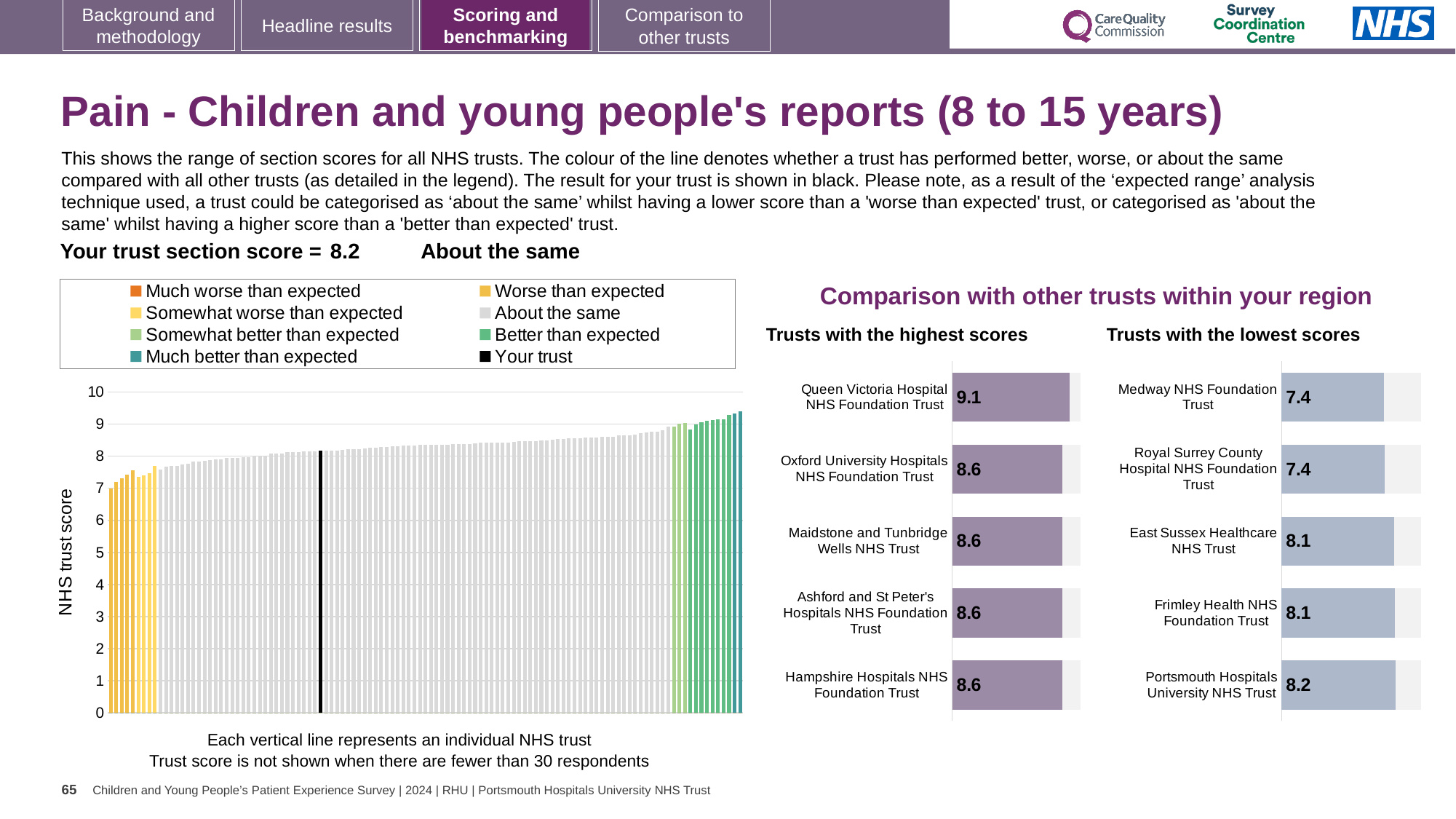
In the 'Trusts with the highest scores' chart, what is the score for Queen Victoria Hospital NHS Foundation Trust? 9.1 How many trusts are shown in the 'Trusts with the lowest scores' chart? 5 How many entries does the legend of the main NHS trust score chart list? 8 Which is larger: the score for East Sussex Healthcare NHS Trust or the score for Portsmouth Hospitals University NHS Trust in the lowest scores chart? Portsmouth Hospitals University NHS Trust What kind of chart is the main chart with the y-axis labelled 'NHS trust score'? Bar chart In the 'Trusts with the highest scores' chart, which trust has the highest score? Queen Victoria Hospital NHS Foundation Trust In the 'Trusts with the lowest scores' chart, what is the score for Medway NHS Foundation Trust? 7.4 In the 'Trusts with the highest scores' chart, what is the difference between Queen Victoria Hospital NHS Foundation Trust and Oxford University Hospitals NHS Foundation Trust? 0.5 In the main NHS trust score chart, do the bar heights rise or fall from left to right? Rise In the 'Trusts with the lowest scores' chart, what is the score for Portsmouth Hospitals University NHS Trust? 8.2 In the 'Trusts with the lowest scores' chart, which trust has the highest score shown? Portsmouth Hospitals University NHS Trust What is the difference between the score for Queen Victoria Hospital NHS Foundation Trust in the highest scores chart and the score for Medway NHS Foundation Trust in the lowest scores chart? 1.7